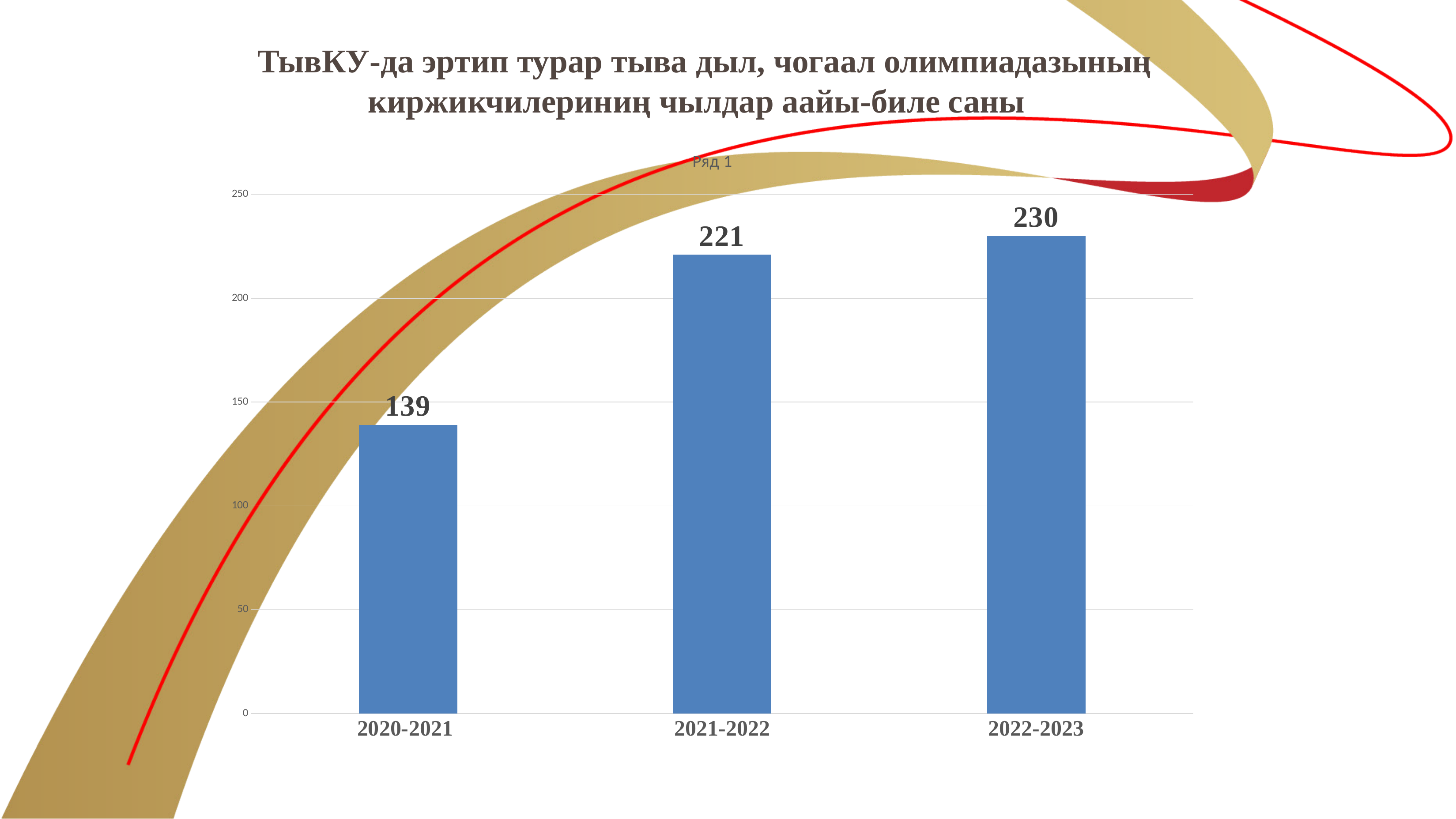
What kind of chart is shown on the slide? bar chart Which is larger, the value for 2020-2021 or the value for 2021-2022? 2021-2022 Is the value for 2020-2021 greater or less than 150? less Which category has the lowest value? 2020-2021 What is the value for 2022-2023? 230 Do the values rise or fall from 2020-2021 to 2022-2023? rise What is the difference between the values for 2021-2022 and 2020-2021? 82 How many categories are shown on the x axis? 3 What is the value for 2020-2021? 139 What is the difference between the values for 2022-2023 and 2021-2022? 9 What is the value for 2021-2022? 221 Which category has the highest value? 2022-2023